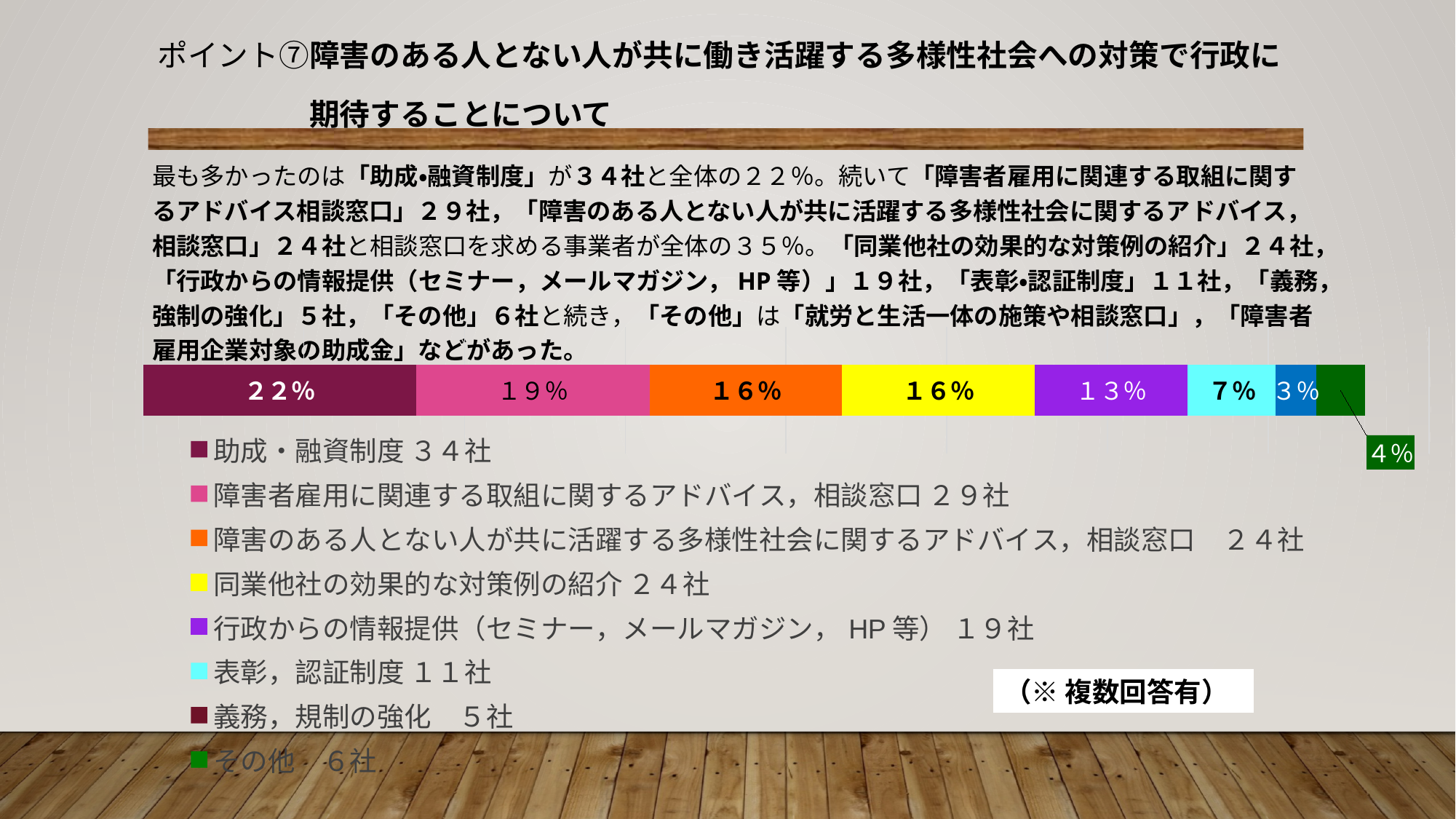
What is the difference in percentage points between the 助成・融資制度 segment and the 障害者雇用に関連する取組に関するアドバイス，相談窓口 segment? 3 percentage points What percentage does the 助成・融資制度 segment show in the stacked bar? 22% What kind of chart is shown on the slide? Stacked bar chart Which segment is larger: 表彰，認証制度 or その他? 表彰，認証制度 How many entries does the legend list? 8 What percentage is shown for the 義務，規制の強化 segment? 3% What percentage does the 行政からの情報提供（セミナー，メールマガジン，HP等） segment show? 13% How many segments make up the stacked bar? 8 What percentage is shown for the その他 segment? 4% Which category has the smallest share in the stacked bar? 義務，規制の強化 What percentage is shown for the 表彰，認証制度 segment? 7% Which category has the largest share in the stacked bar? 助成・融資制度